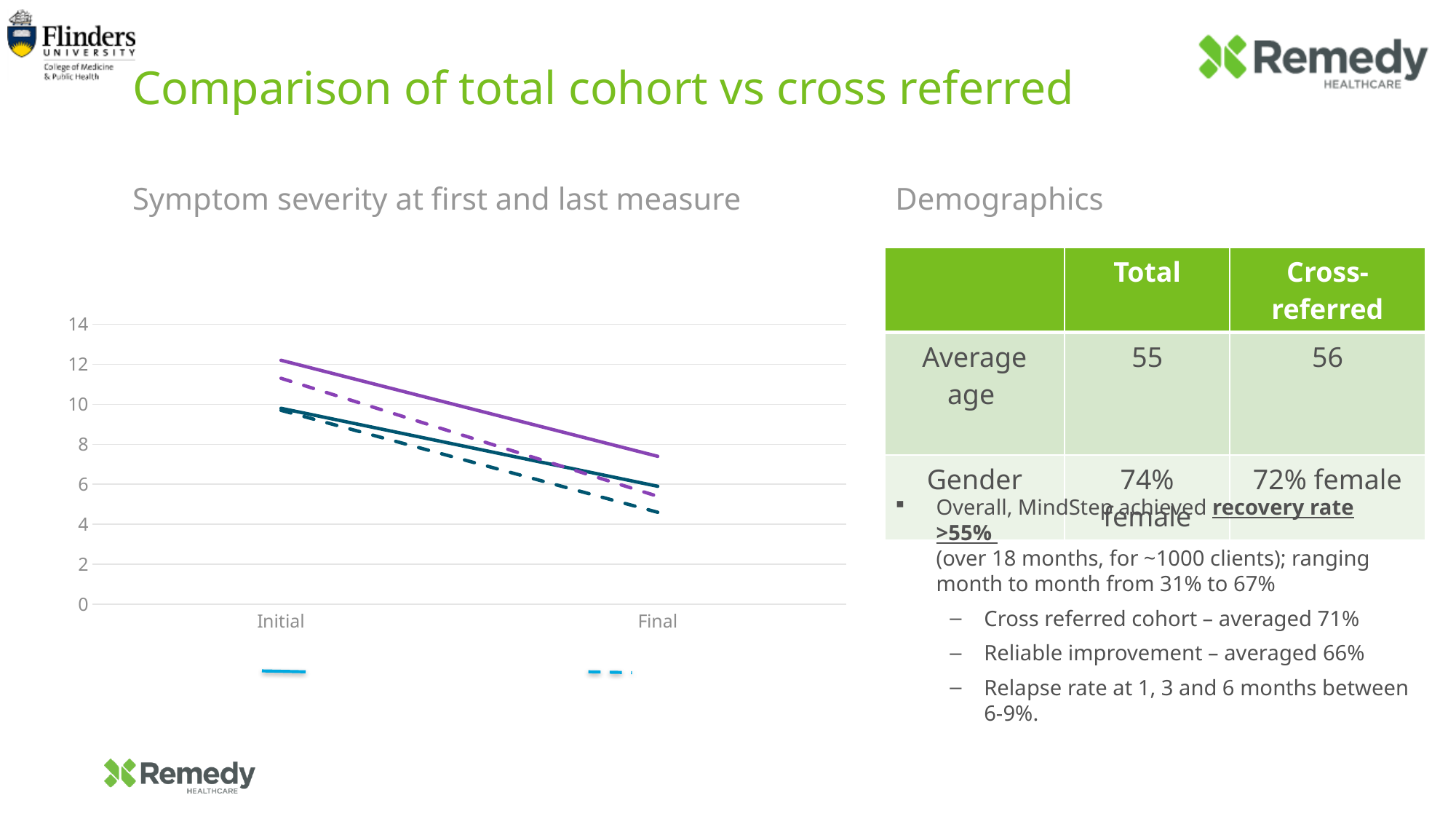
In the symptom severity chart, is the dashed purple line's value at Initial greater or less than 10? greater In the symptom severity chart, is the solid purple line's value at Final greater or less than 6? greater In the symptom severity chart, is the dashed teal line's value at Final greater or less than 6? less In the symptom severity chart, at Final, which is larger: the solid purple line or the solid teal line? the solid purple line Do the lines in the symptom severity chart rise or fall from Initial to Final? fall What is the title of the chart on the left of the slide? Symptom severity at first and last measure In the symptom severity chart, which line is highest at Initial? the solid purple line In the symptom severity chart, which line is lowest at Final? the dashed teal line What kind of chart is shown under "Symptom severity at first and last measure"? line chart What are the two x-axis labels on the symptom severity chart? Initial and Final How many points are on the x axis of the symptom severity chart? 2